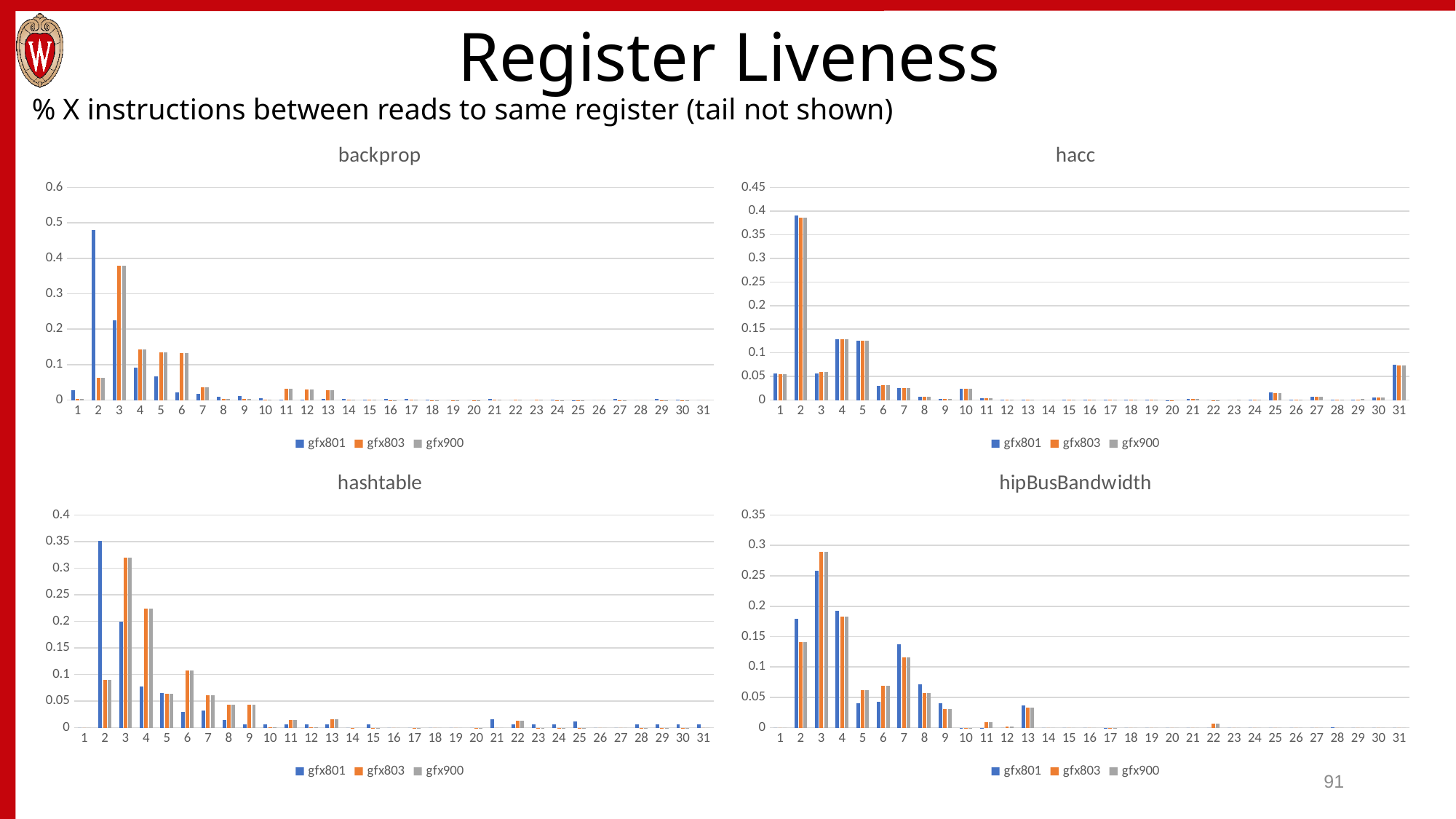
In the hipBusBandwidth chart, which x-axis category has the highest gfx803 value? 3 In the hipBusBandwidth chart, is the gfx801 value at category 2 greater or less than 0.15? greater In the hacc chart, which x-axis category has the highest gfx803 value? 2 How many series does the legend of the backprop chart list? 3 In the hashtable chart, is the gfx803 value at category 3 greater or less than 0.3? greater In the hashtable chart, which x-axis category has the highest gfx801 value? 2 What kind of chart is the backprop chart? bar chart In the backprop chart, is the gfx801 value at category 2 greater or less than 0.4? greater In the hacc chart, which is larger for gfx801: the value at category 4 or the value at category 31? category 4 In the hashtable chart, at category 2, which series is larger: gfx801 or gfx803? gfx801